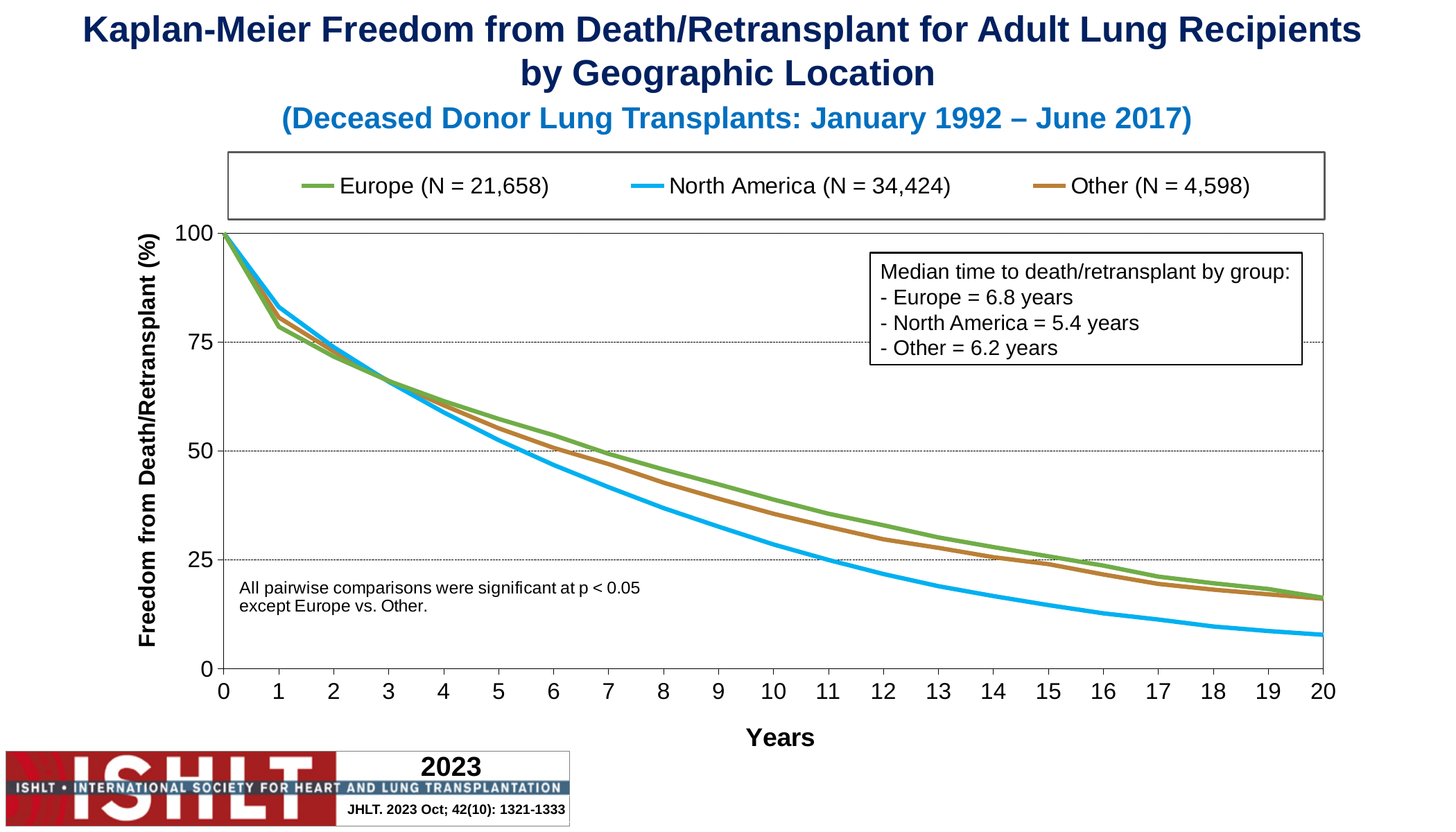
Is the value for North America at 20 years greater or less than 25? less What kind of chart is shown on the slide? line chart How many series does the legend list? 3 Do the curves rise or fall as the years increase? fall Which group has the shortest median time to death/retransplant? North America What is the median time to death/retransplant for Europe? 6.8 years Which group has the longest median time to death/retransplant? Europe At 15 years, which curve is higher, Europe or North America? Europe Is the value for Europe at 10 years greater or less than 25? greater What is the difference between the median time to death/retransplant for Europe and for North America? 1.4 years What is the median time to death/retransplant for the Other group? 6.2 years What is the median time to death/retransplant for North America? 5.4 years